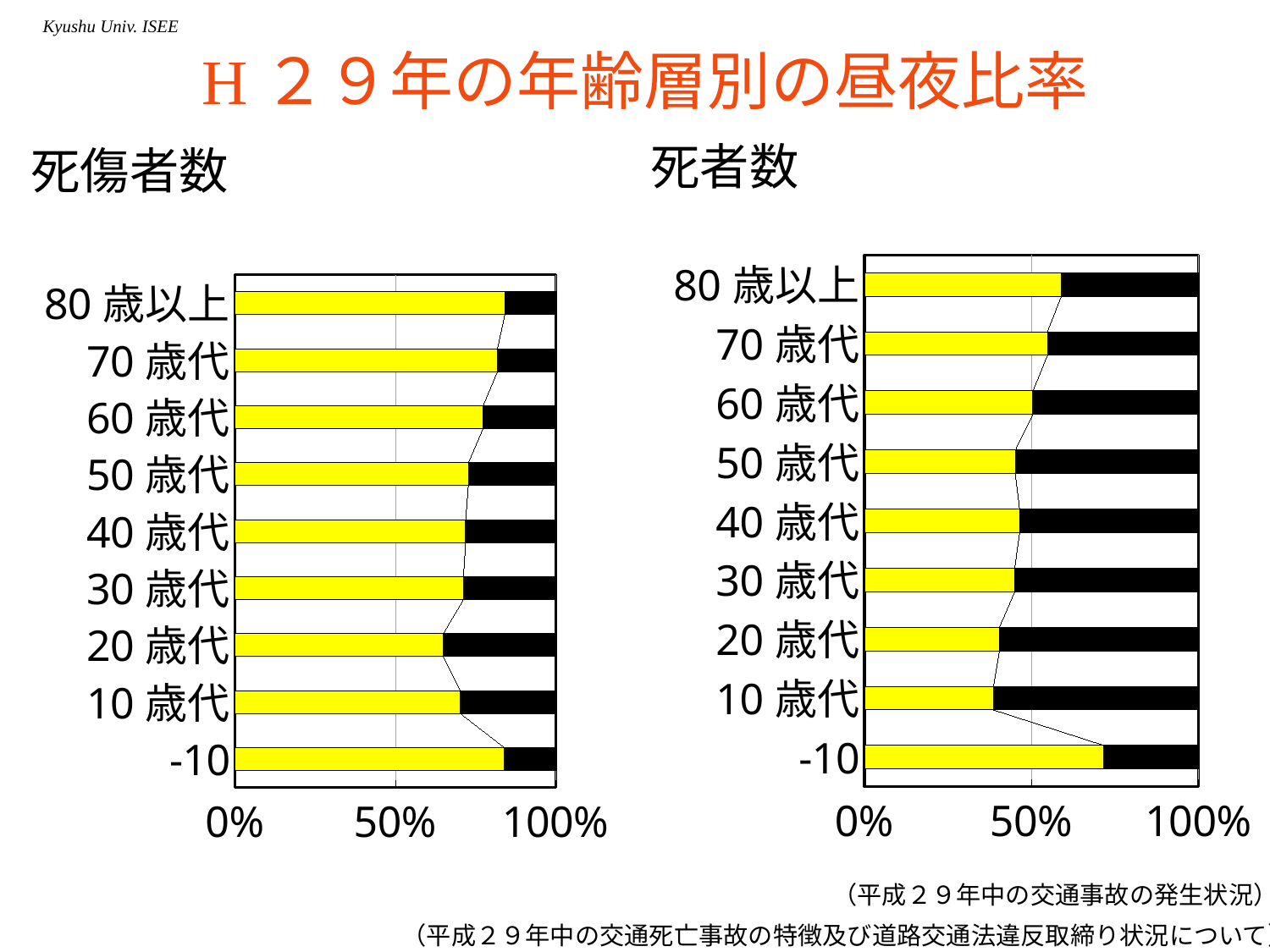
How many age categories are shown on the right chart titled 死者数? 9 On the right chart titled 死者数, which has the larger yellow segment, 80歳以上 or 10歳代? 80歳以上 On the right chart titled 死者数, is the yellow segment for 20歳代 greater or less than 50%? less How many age categories are shown on the left chart titled 死傷者数? 9 What kind of chart is the left chart titled 死傷者数? bar chart On the right chart titled 死者数, is the yellow segment for -10 greater or less than 50%? greater On the right chart titled 死者数, which age category has the largest yellow segment? -10 On the right chart titled 死者数, is the yellow segment for 10歳代 greater or less than 50%? less On the left chart titled 死傷者数, which has the larger yellow segment, 80歳以上 or 20歳代? 80歳以上 On the left chart titled 死傷者数, which age category has the smallest yellow segment? 20歳代 What is the title of the slide? H２９年の年齢層別の昼夜比率